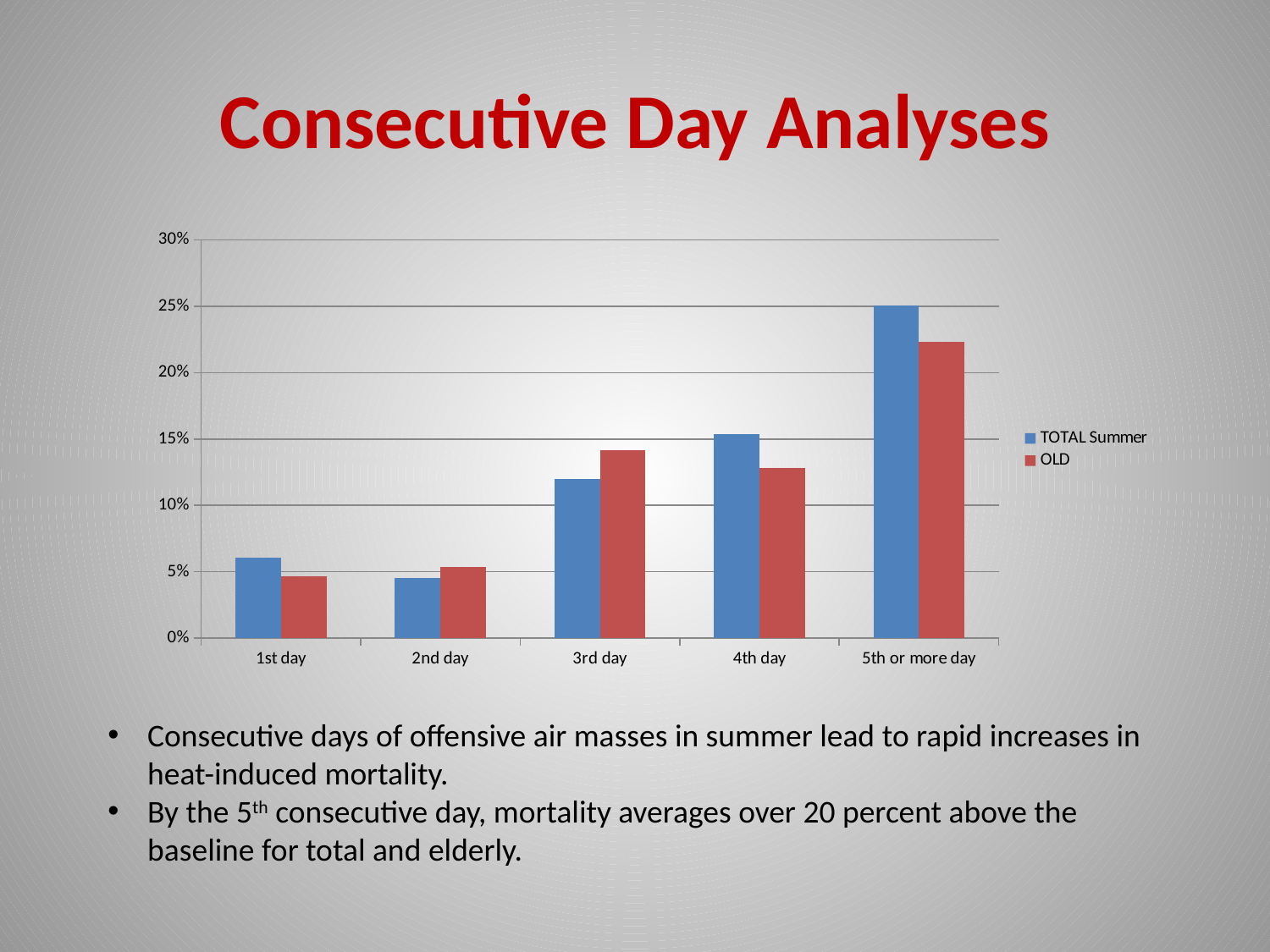
Which category has the highest value for the TOTAL Summer series? 5th or more day For the 4th day, which series has the larger value, TOTAL Summer or OLD? TOTAL Summer For the 3rd day, which series has the larger value, TOTAL Summer or OLD? OLD Which category has the lowest value for the TOTAL Summer series? 2nd day Is the value for OLD on the 5th or more day greater or less than 20%? greater Is the value for TOTAL Summer on the 3rd day greater or less than 10%? greater How many categories are shown on the x axis? 5 Which category has the highest value for the OLD series? 5th or more day Does the TOTAL Summer series rise or fall from the 2nd day to the 5th or more day? rise What kind of chart is shown on the slide? bar chart Is the value for OLD on the 1st day greater or less than 5%? less How many series does the legend list? 2